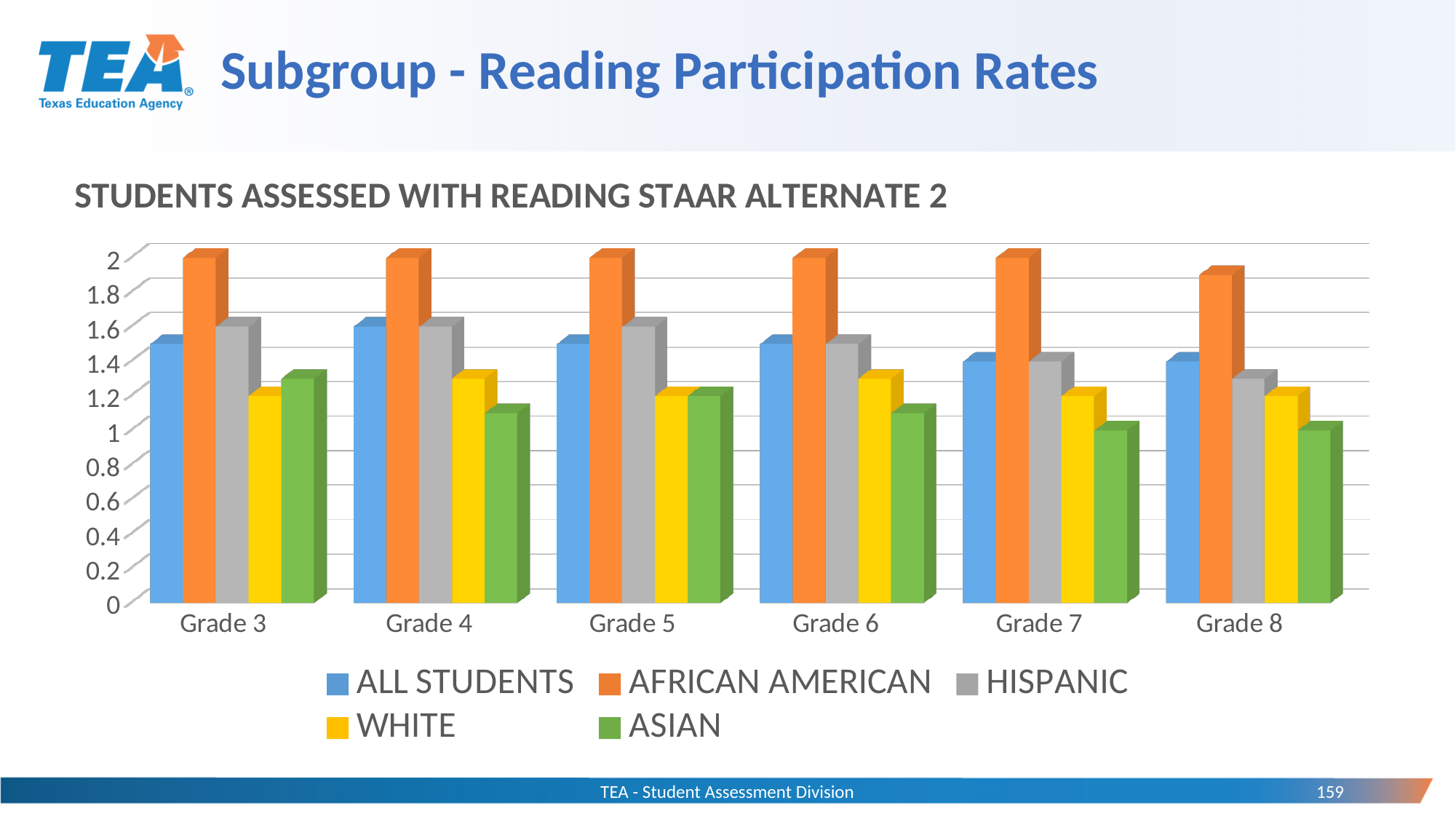
What is the title of the chart? STUDENTS ASSESSED WITH READING STAAR ALTERNATE 2 Which series is shown in orange in the legend? AFRICAN AMERICAN Is the value for ASIAN in Grade 7 greater or less than 1.2? less Which series has the lowest value for Grade 7? ASIAN Is the value for AFRICAN AMERICAN in Grade 3 greater or less than 1.8? greater Which series has the highest value for Grade 5? AFRICAN AMERICAN How many grade categories are shown on the x axis? 6 How many series does the legend list? 5 For Grade 3, which is larger: HISPANIC or WHITE? HISPANIC What kind of chart is shown on the slide? bar chart Is the value for HISPANIC in Grade 8 greater or less than 1.6? less For Grade 4, which is larger: WHITE or ASIAN? WHITE